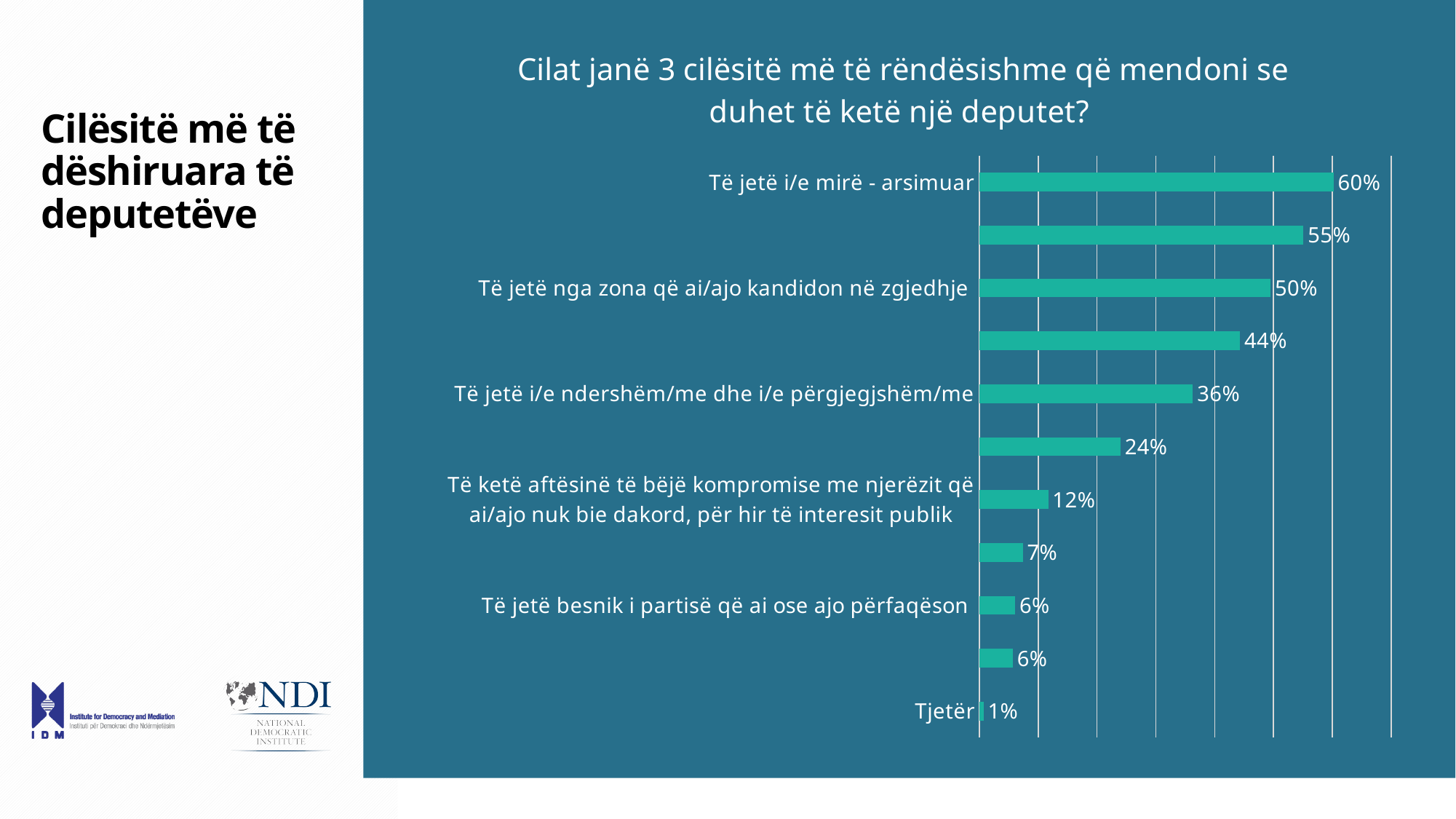
What percentage is shown for "Të jetë i/e ndershëm/me dhe i/e përgjegjshëm/me"? 36% Which is larger: the value for "Të jetë i/e ndershëm/me dhe i/e përgjegjshëm/me" or the value for "Të ketë aftësinë të bëjë kompromise me njerëzit që ai/ajo nuk bie dakord, për hir të interesit publik"? Të jetë i/e ndershëm/me dhe i/e përgjegjshëm/me Which category has the highest value in the chart? Të jetë i/e mirë - arsimuar How many bars are plotted in the chart? 11 What kind of chart is shown on the slide? Bar chart What percentage is shown for "Të jetë besnik i partisë që ai ose ajo përfaqëson"? 6% What percentage is shown for "Të jetë nga zona që ai/ajo kandidon në zgjedhje"? 50% What is the difference between the values for "Të jetë i/e mirë - arsimuar" and "Të jetë nga zona që ai/ajo kandidon në zgjedhje"? 10% What is the title of the chart? Cilat janë 3 cilësitë më të rëndësishme që mendoni se duhet të ketë një deputet? What percentage is shown for "Tjetër"? 1% What percentage is shown for "Të jetë i/e mirë - arsimuar"? 60% Which category has the lowest value in the chart? Tjetër